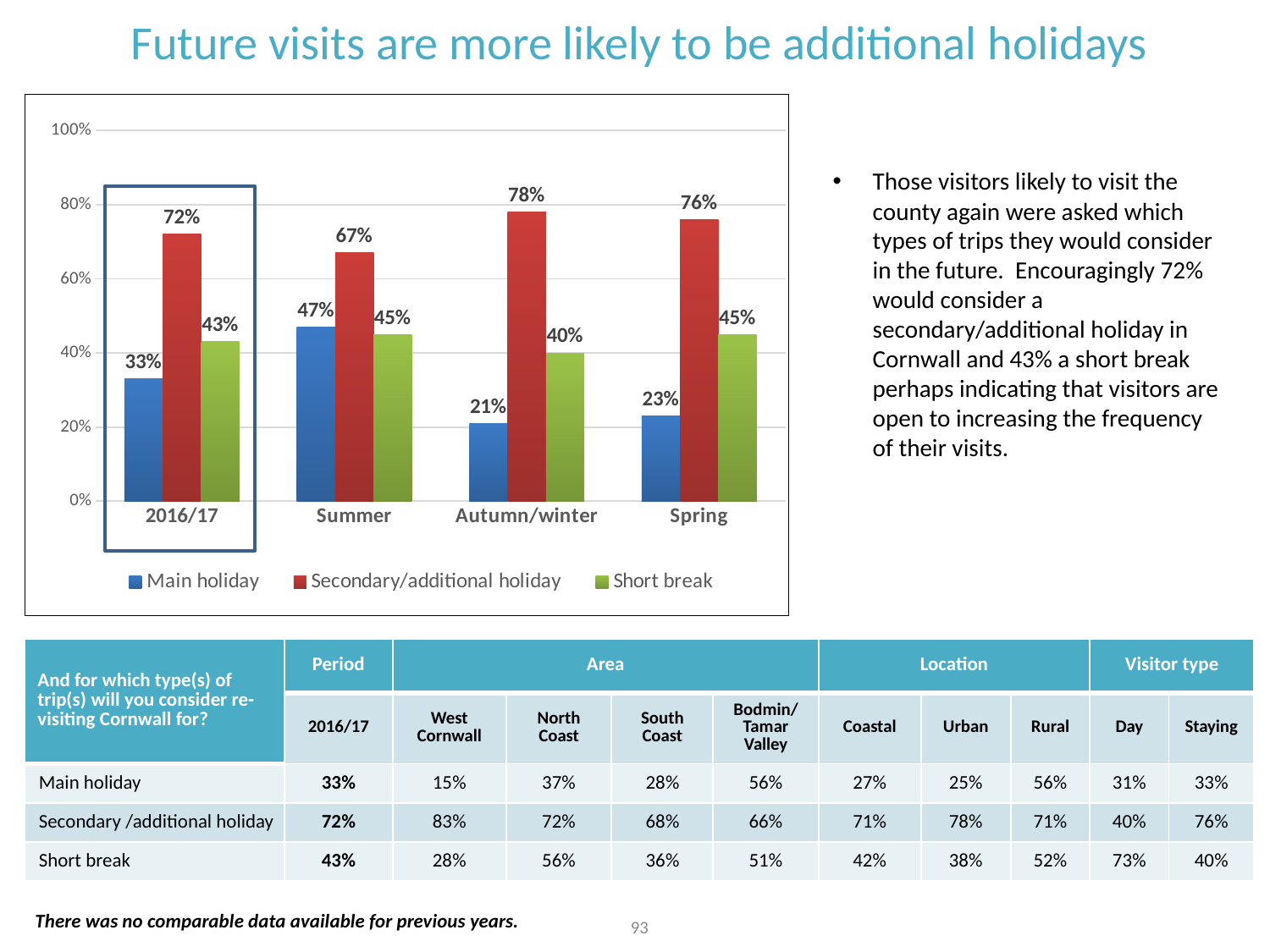
Which series is shown in red in the chart? Secondary/additional holiday What is the difference between the Secondary/additional holiday and Main holiday values in Spring? 53% Is the value for Secondary/additional holiday in Summer greater or less than 60%? greater What is the value for Secondary/additional holiday in 2016/17? 72% What is the value for Short break in Summer? 45% What kind of chart is shown on the slide? Bar chart Which category has the lowest value for Main holiday? Autumn/winter How many series does the legend list? 3 Which category has the highest value for Secondary/additional holiday? Autumn/winter How many categories are shown on the x axis? 4 Which is larger in 2016/17: Main holiday or Short break? Short break What is the value for Main holiday in Autumn/winter? 21%